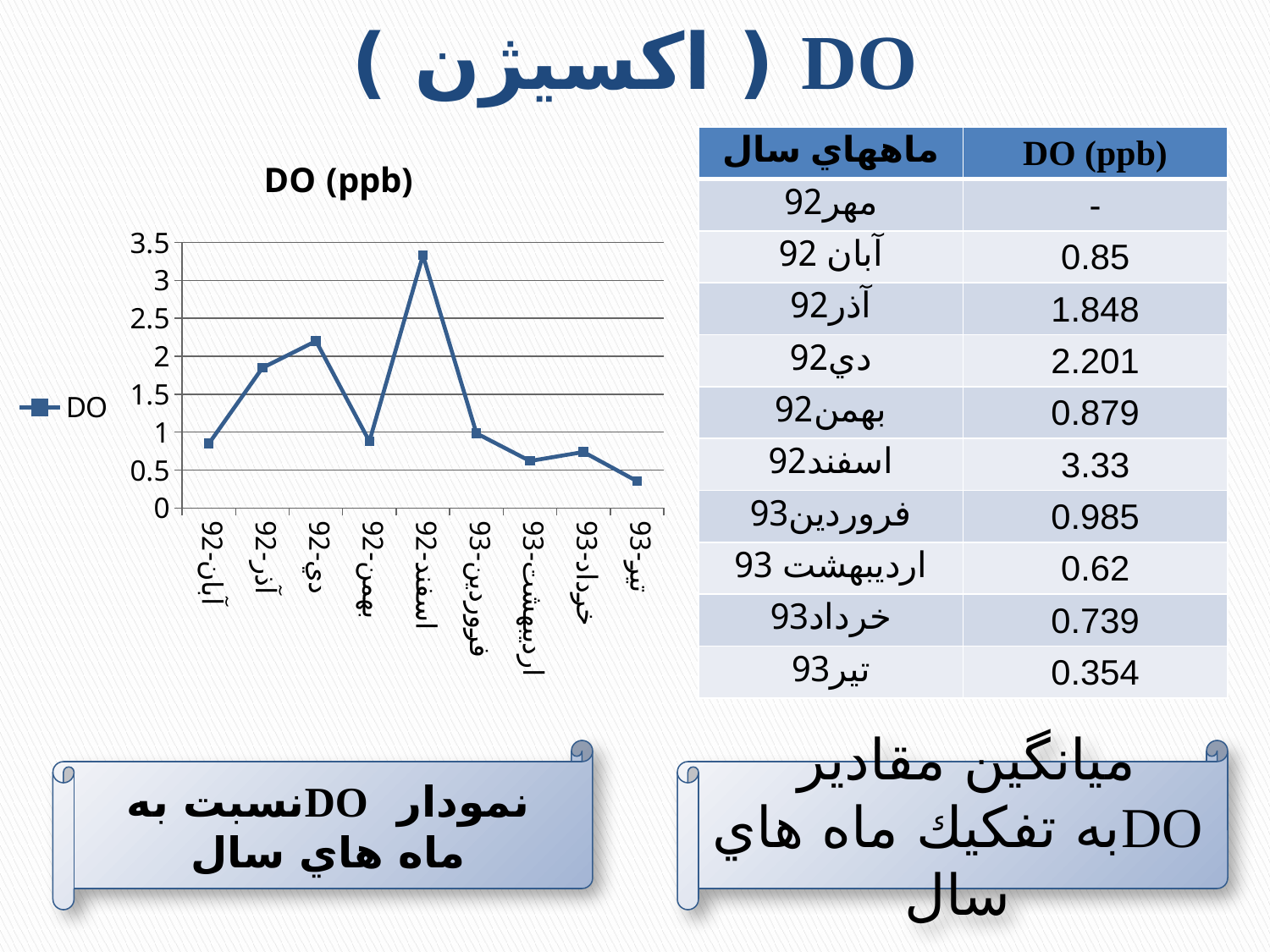
Which month has the lowest DO value on the chart? تير 93 Which has a larger DO value on the chart, آذر 92 or بهمن 92? آذر 92 Is the DO value for دي 92 greater or less than 2.5? less What kind of chart is shown on the slide? line chart Which month has the highest DO value on the chart? اسفند 92 Do the DO values rise or fall from اسفند 92 to تير 93 on the chart? fall According to the table, what is the DO (ppb) value for تير 93? 0.354 Is the DO value for اسفند 92 greater or less than 3? greater How many data points are plotted on the DO (ppb) line chart? 9 Using the table values, what is the difference between the DO value for اسفند 92 and تير 93? 2.976 How many series does the legend of the DO (ppb) chart list? 1 According to the table, what is the DO (ppb) value for اسفند 92? 3.33